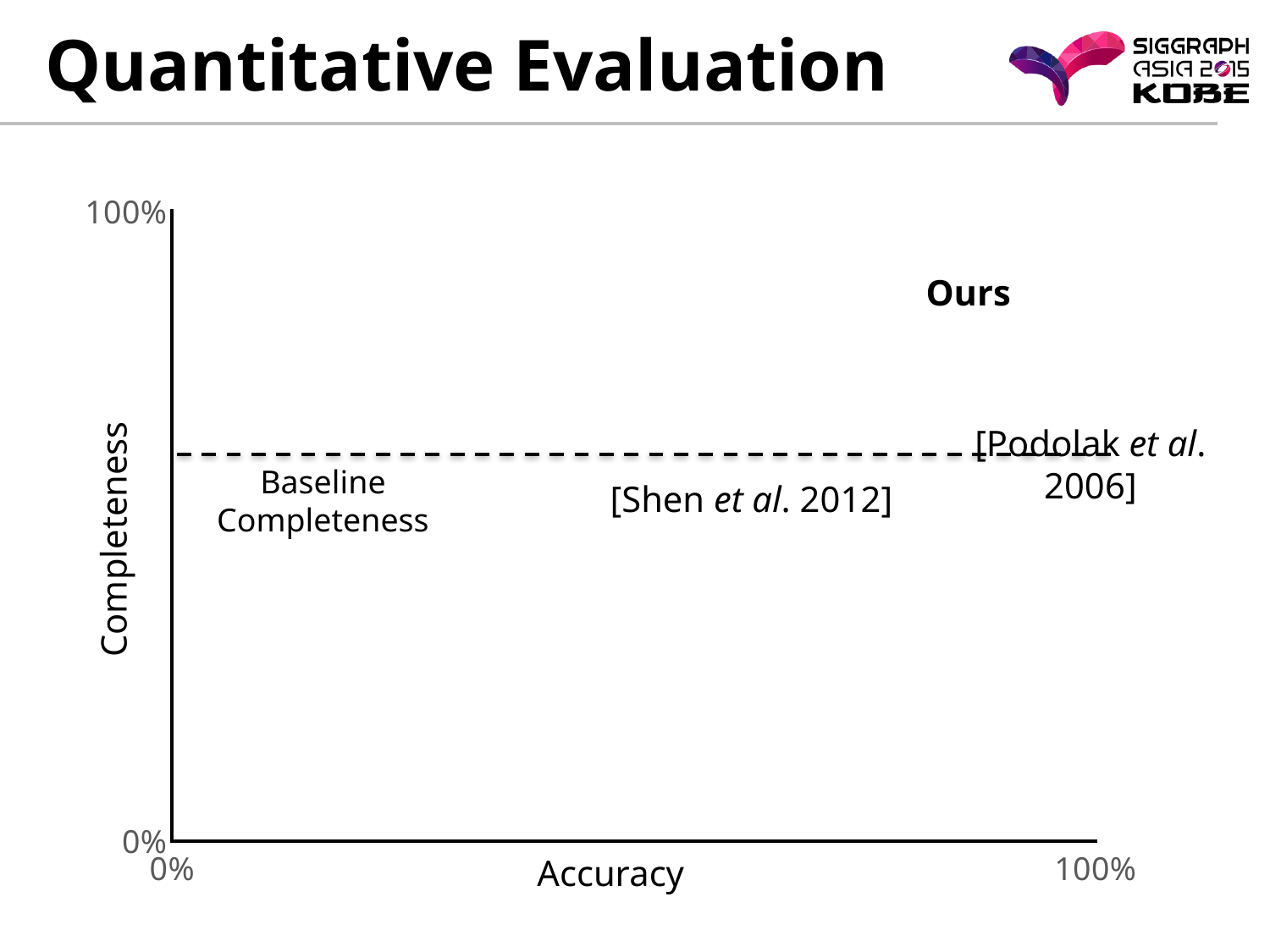
Which labelled method appears highest on the Completeness axis? Ours What is the minimum value shown on the Completeness axis? 0% How many methods are labelled in the plot area of the chart? 3 Is the Ours label positioned above or below the dashed Baseline Completeness line? above What quantity is plotted on the horizontal axis of the chart? Accuracy What is the title of the chart on this slide? Quantitative Evaluation Which labelled method appears lowest on the Completeness axis? [Shen et al. 2012] Is the [Shen et al. 2012] label positioned above or below the dashed Baseline Completeness line? below Which is positioned higher on the Completeness axis, Ours or [Shen et al. 2012]? Ours What is the maximum value shown on the Accuracy axis? 100%